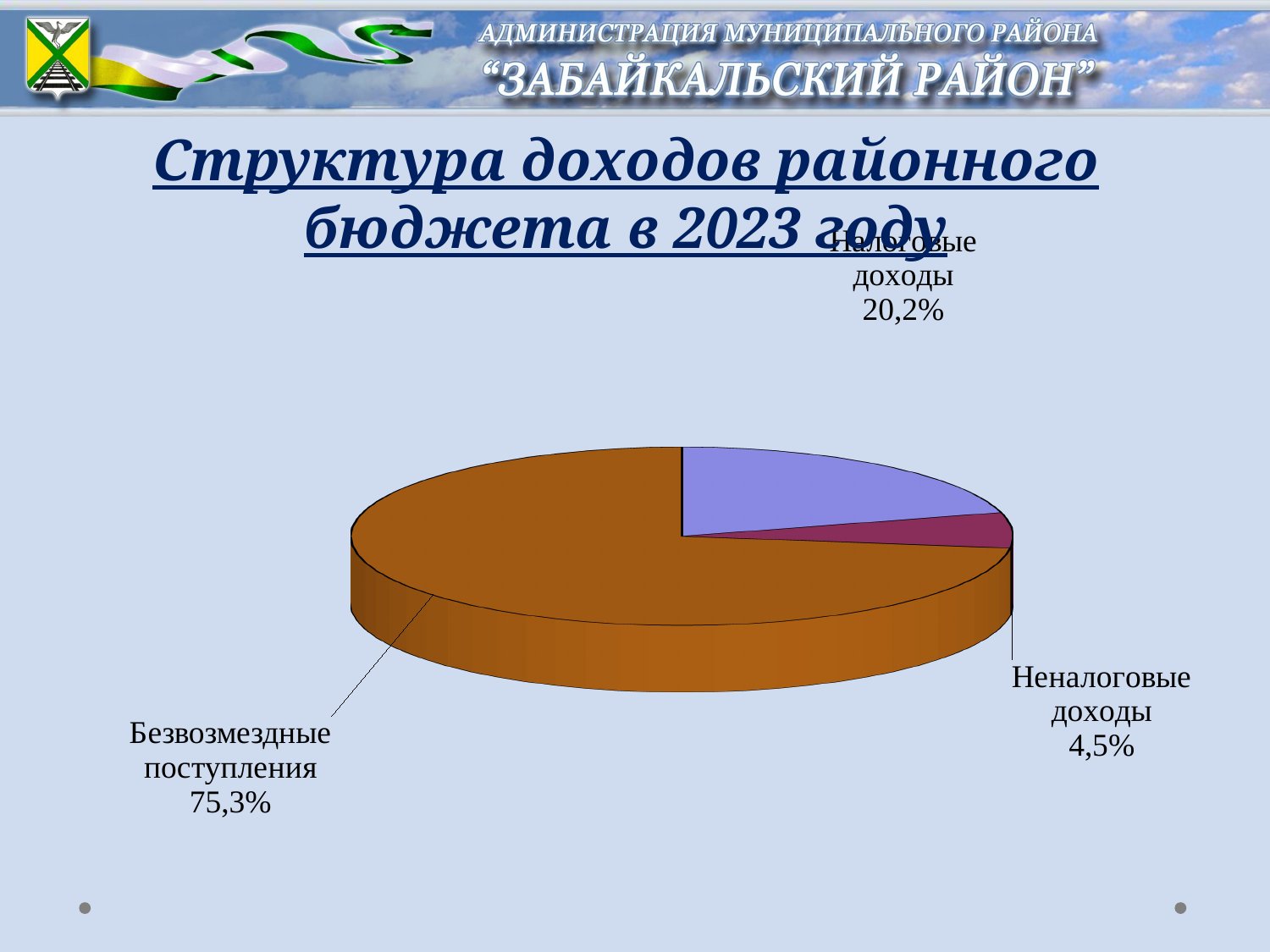
What share of the pie does "Безвозмездные поступления" have? 75,3% What kind of chart is shown on the slide? Pie chart How many slices does the pie chart have? 3 What is the difference in percentage points between "Безвозмездные поступления" and "Налоговые доходы"? 55,1 What is the title of the chart on the slide? Структура доходов районного бюджета в 2023 году Which slice of the pie is the largest? Безвозмездные поступления What share of the pie does "Налоговые доходы" have? 20,2% What is the difference in percentage points between "Налоговые доходы" and "Неналоговые доходы"? 15,7 Which slice of the pie is the smallest? Неналоговые доходы Which is larger, "Налоговые доходы" or "Неналоговые доходы"? Налоговые доходы What share of the pie does "Неналоговые доходы" have? 4,5% What colour is the "Безвозмездные поступления" slice? Brown (orange-brown)